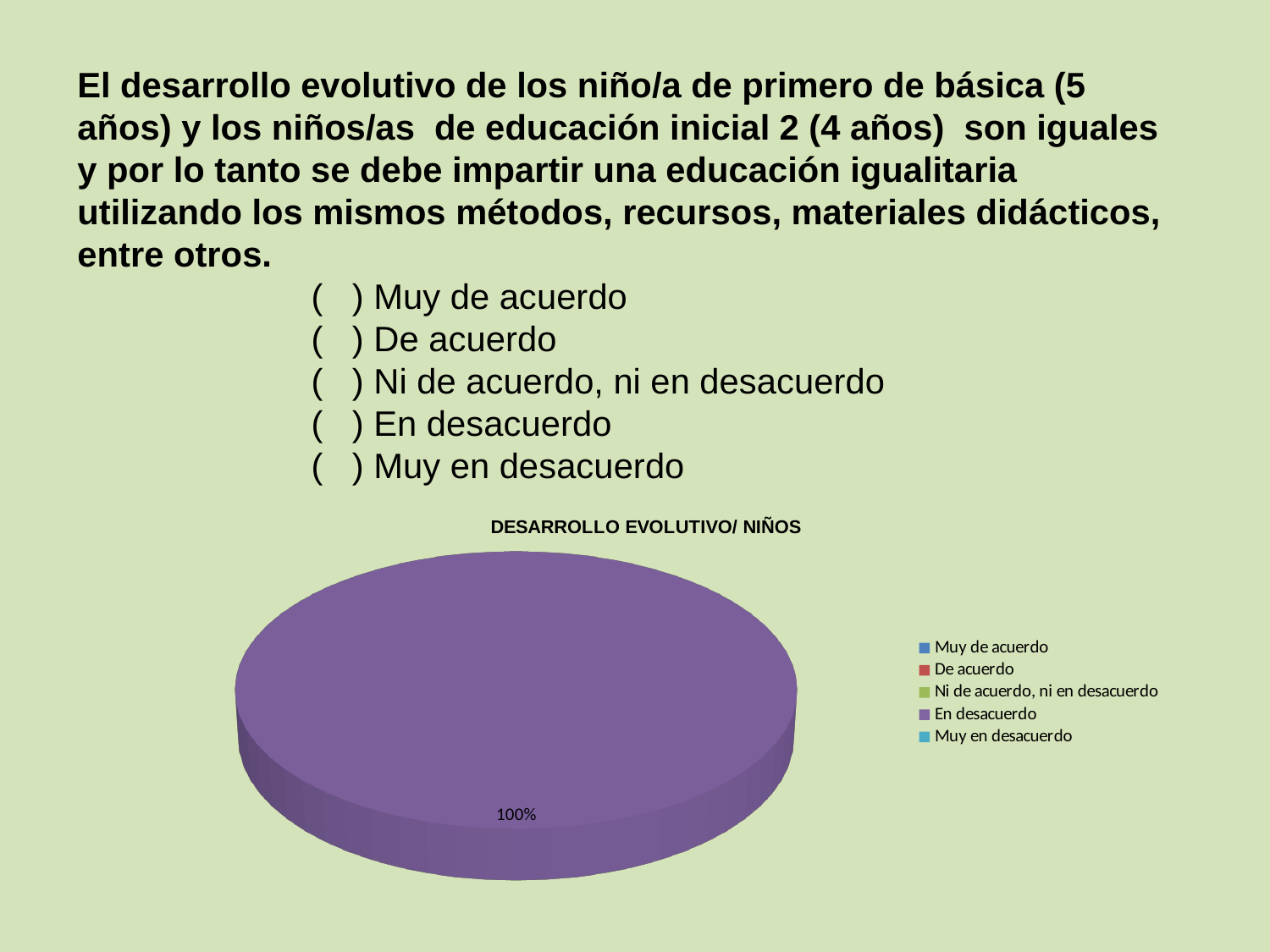
What percentage is shown on the data label of the pie chart? 100% How many slices are visible in the pie chart? 1 What is the title of the chart? DESARROLLO EVOLUTIVO/ NIÑOS Is the value for 'En desacuerdo' greater or less than 50%? greater What kind of chart is shown on the slide? pie chart What colour is the slice representing 'En desacuerdo'? purple How many entries does the chart's legend list? 5 Which is larger in the pie chart, the share for 'En desacuerdo' or the share for 'Muy de acuerdo'? En desacuerdo Which category does the single visible slice of the pie chart represent? En desacuerdo What share of the pie does the 'En desacuerdo' slice take? 100%